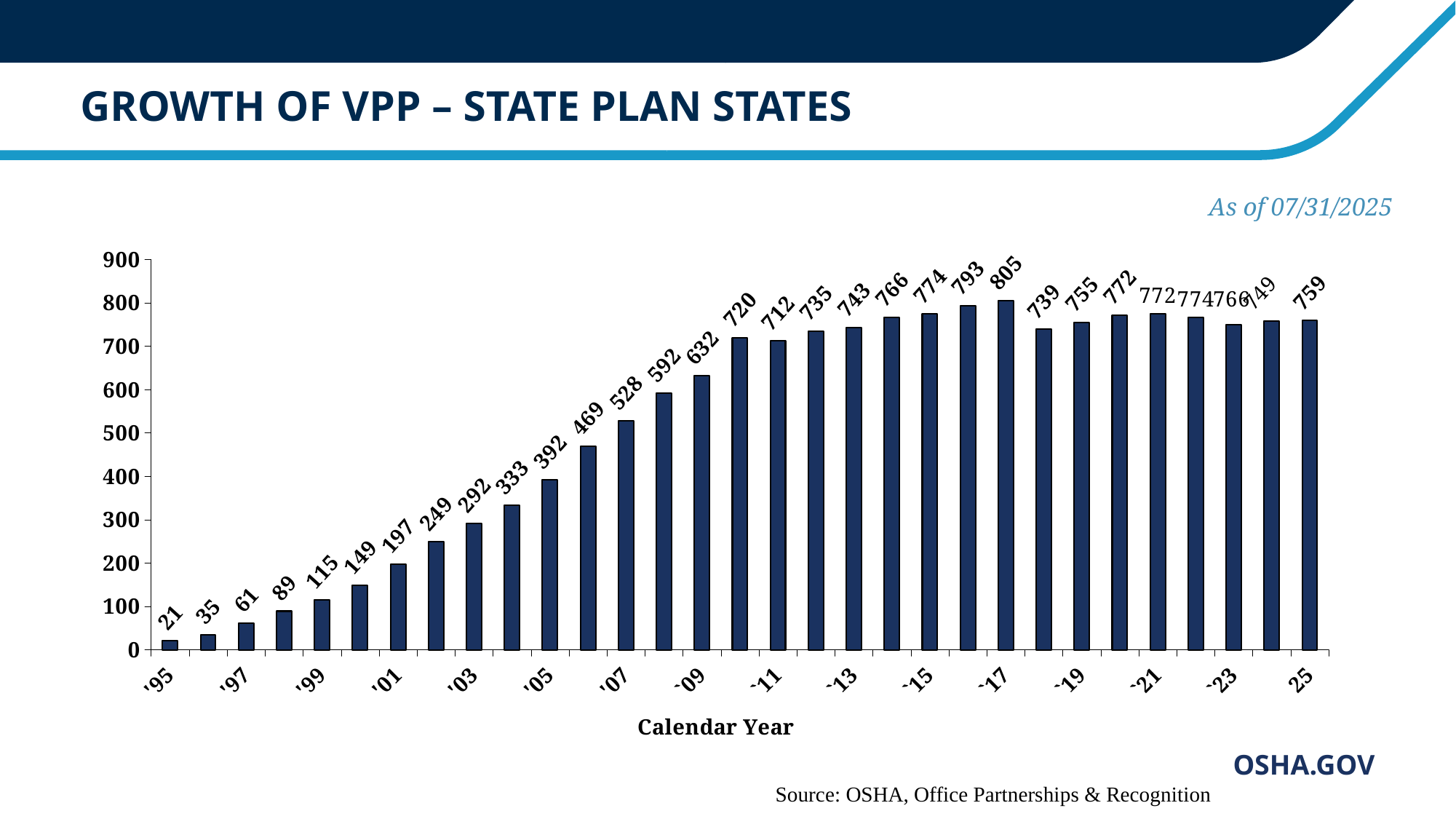
How many bars are plotted in the chart? 31 What is the x-axis title of the chart? Calendar Year Which is larger, the value for '11 or the value for '13? '13 What is the value for '25? 759 Which year has the lowest value? '95 What is the difference between the values for '17 and '19? 50 Which year has the highest value? '17 What is the value for '17? 805 What is the value for '95? 21 Is the value for '05 greater or less than 400? less What is the value for '09? 632 What type of chart is shown on the slide? bar chart